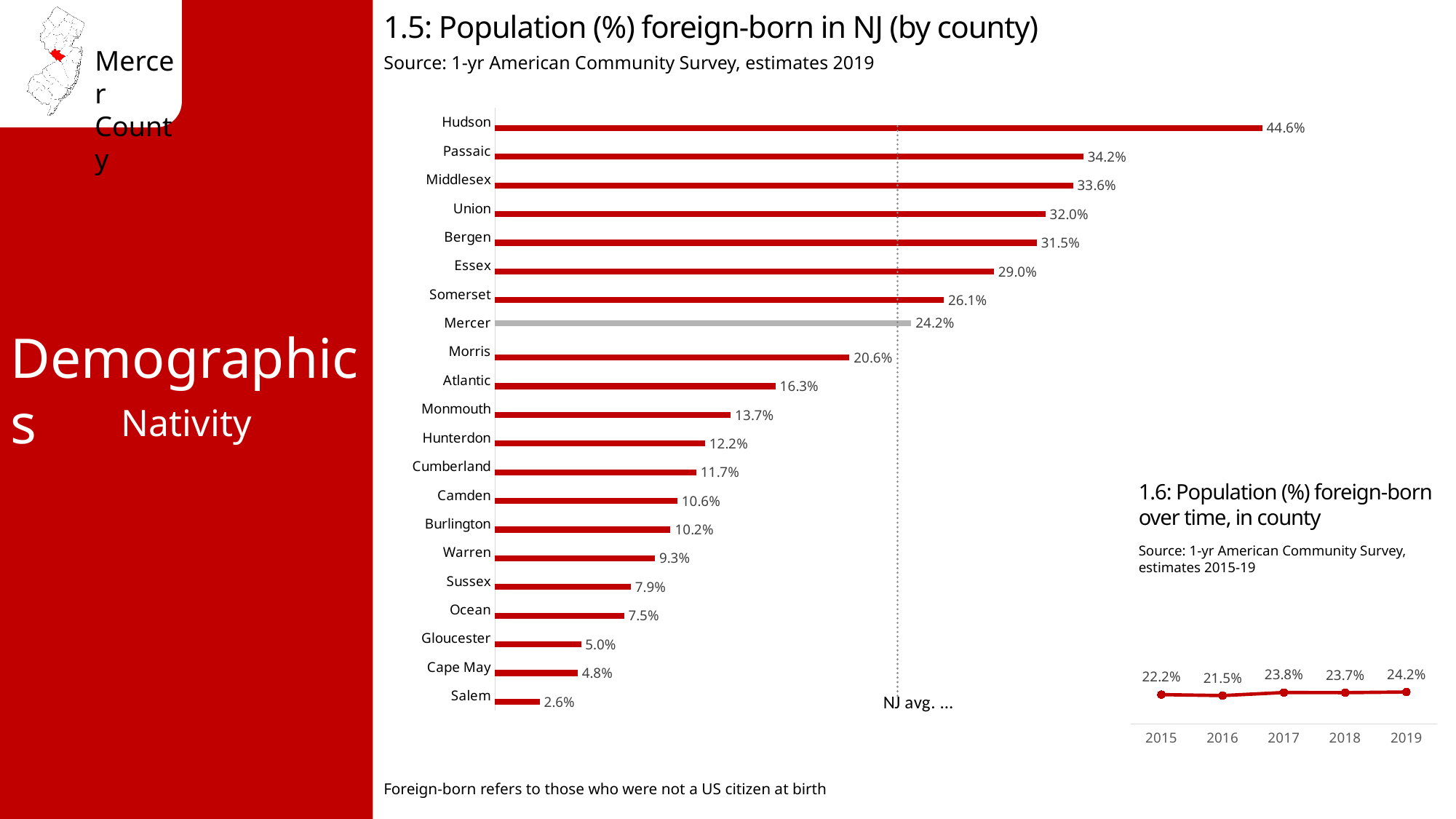
In chart 1.5 (Population (%) foreign-born in NJ by county), which county's bar is shown in grey rather than red? Mercer In chart 1.5 (Population (%) foreign-born in NJ by county), what is the difference between Hudson and Passaic? 10.4% In chart 1.5 (Population (%) foreign-born in NJ by county), what is the value for Essex? 29.0% In chart 1.6 (Population (%) foreign-born over time, in county), how many data points are plotted? 5 In chart 1.5 (Population (%) foreign-born in NJ by county), which county has the lowest value? Salem In chart 1.5 (Population (%) foreign-born in NJ by county), which is larger, Camden or Burlington? Camden In chart 1.5 (Population (%) foreign-born in NJ by county), which county has the highest value? Hudson In chart 1.6 (Population (%) foreign-born over time, in county), which year has the lowest value? 2016 In chart 1.5 (Population (%) foreign-born in NJ by county), what is the value for Mercer? 24.2% What kind of chart is chart 1.5 (Population (%) foreign-born in NJ by county)? Bar chart In chart 1.6 (Population (%) foreign-born over time, in county), what is the value for 2017? 23.8% In chart 1.5 (Population (%) foreign-born in NJ by county), how many counties are shown? 21